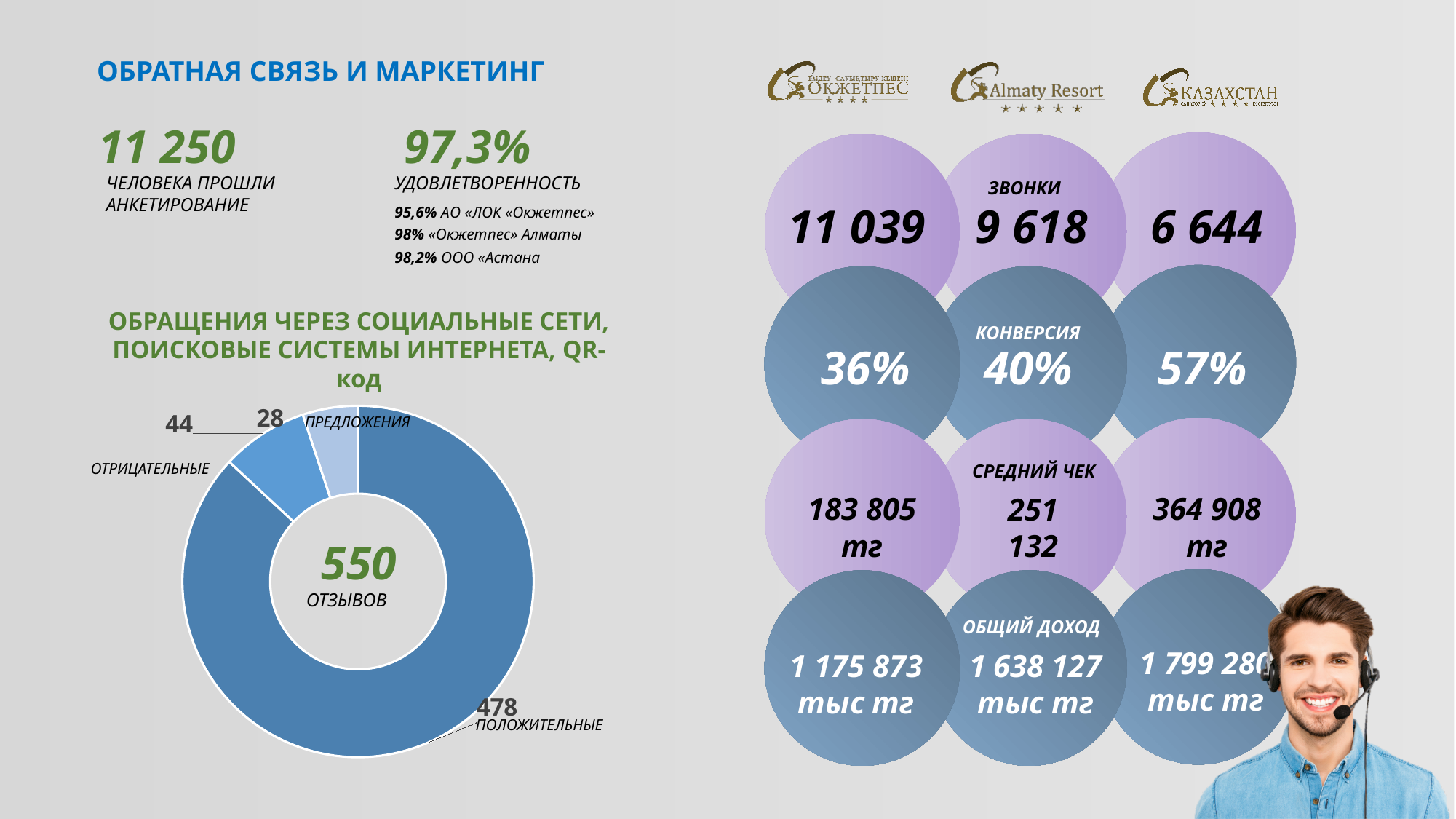
How many categories does the doughnut chart show? 3 What is the total number of reviews (ОТЗЫВОВ) shown in the centre of the doughnut chart? 550 What is the value for ПОЛОЖИТЕЛЬНЫЕ in the doughnut chart? 478 What is the difference between the values for ОТРИЦАТЕЛЬНЫЕ and ПРЕДЛОЖЕНИЯ? 16 What is the difference between the values for ПОЛОЖИТЕЛЬНЫЕ and ОТРИЦАТЕЛЬНЫЕ? 434 Which category has the smallest slice in the doughnut chart? ПРЕДЛОЖЕНИЯ What share of the total reviews does the ОТРИЦАТЕЛЬНЫЕ slice represent? 8% Which is larger in the doughnut chart, ОТРИЦАТЕЛЬНЫЕ or ПРЕДЛОЖЕНИЯ? ОТРИЦАТЕЛЬНЫЕ What is the value for ПРЕДЛОЖЕНИЯ in the doughnut chart? 28 What is the value for ОТРИЦАТЕЛЬНЫЕ in the doughnut chart? 44 What type of chart is shown on the slide? Doughnut chart Which category has the largest slice in the doughnut chart? ПОЛОЖИТЕЛЬНЫЕ